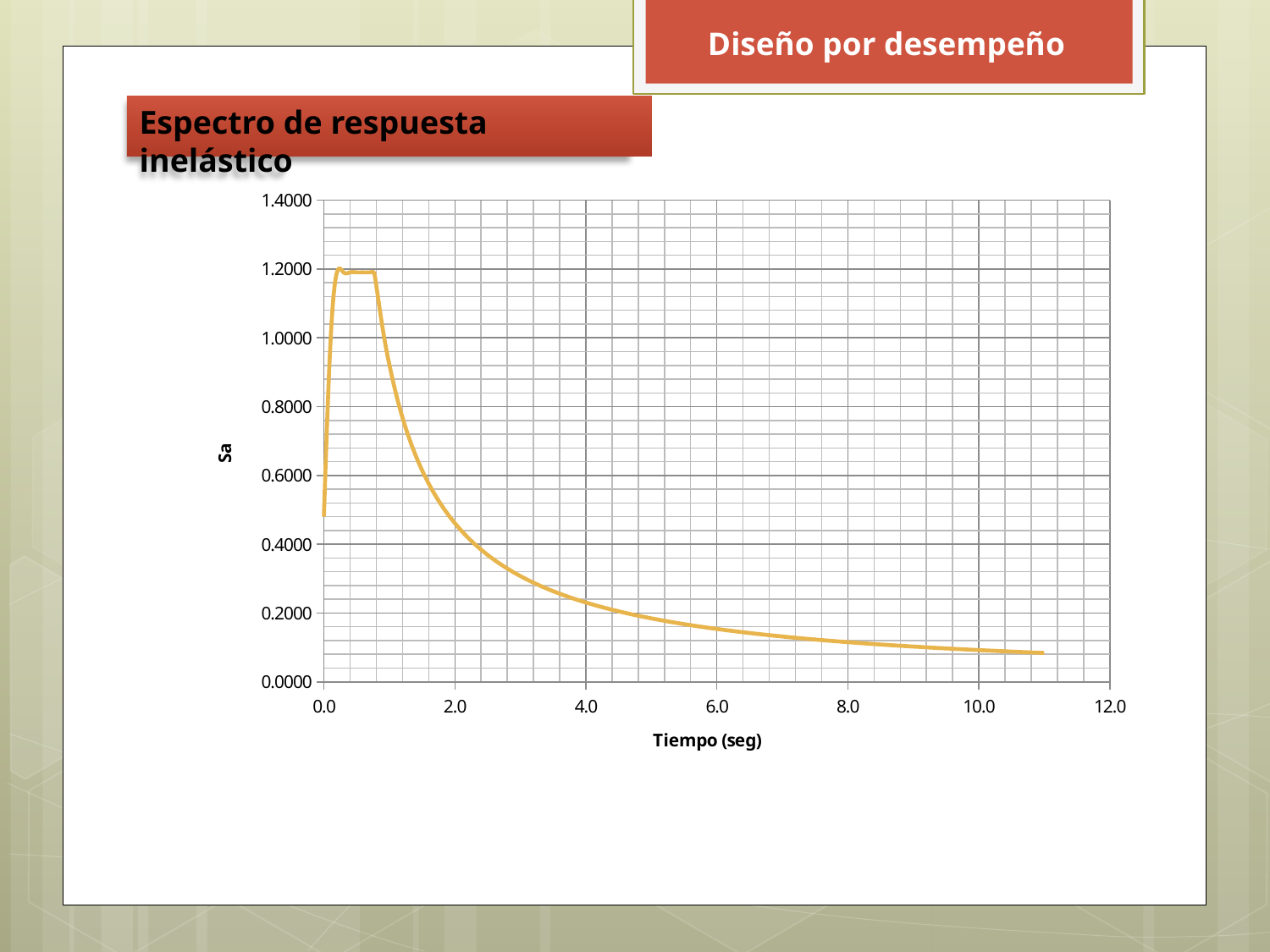
Which is larger, the value of Sa at 2.0 seg or at 6.0 seg? 2.0 seg Is the value of Sa at 10.0 seg greater or less than 0.2000? less Is the maximum value of Sa on the curve greater or less than 1.4000? less Is the value of Sa at 0.0 seg greater or less than 0.6000? less Between 2.0 seg and 10.0 seg, does the value of Sa rise or fall as time increases? fall What is the label of the horizontal axis of the chart? Tiempo (seg) What is the label of the vertical axis of the chart? Sa What kind of chart is shown on the slide? line chart